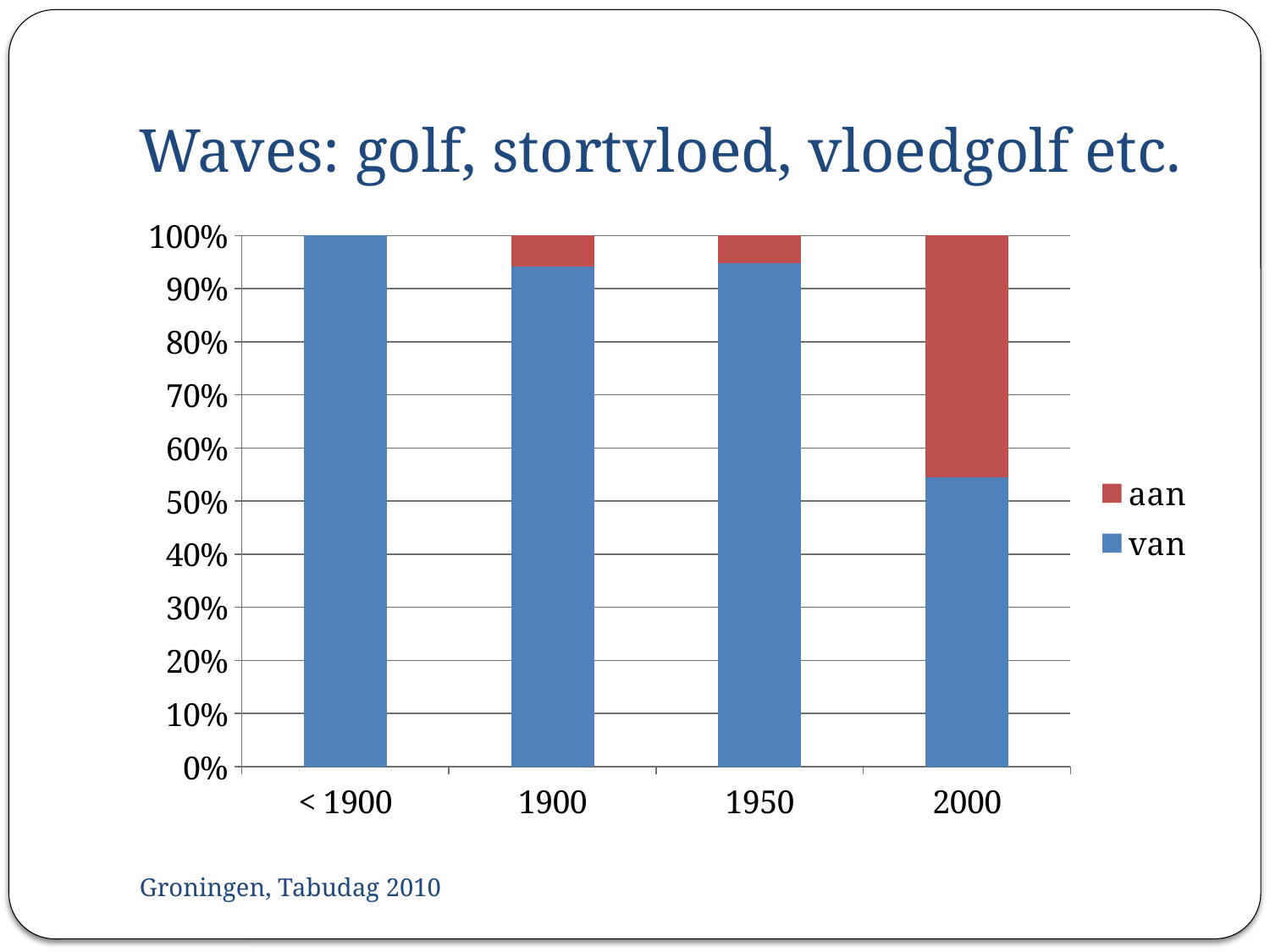
Which category has the lowest share of 'van'? 2000 Which category has the highest share of 'aan'? 2000 What kind of chart is shown on the slide? stacked bar chart What are the two series named in the legend? aan and van Is the value for 'van' in 1900 greater or less than 90%? greater What is the total of the stacked bar for 2000? 100% What is the value of 'van' for the category '< 1900'? 100% How many series does the legend list? 2 Is the value for 'aan' in 2000 greater or less than 50%? less How many categories are shown on the x axis? 4 For the category 2000, which series has the larger share, 'aan' or 'van'? van Is the value for 'van' in 2000 greater or less than 50%? greater